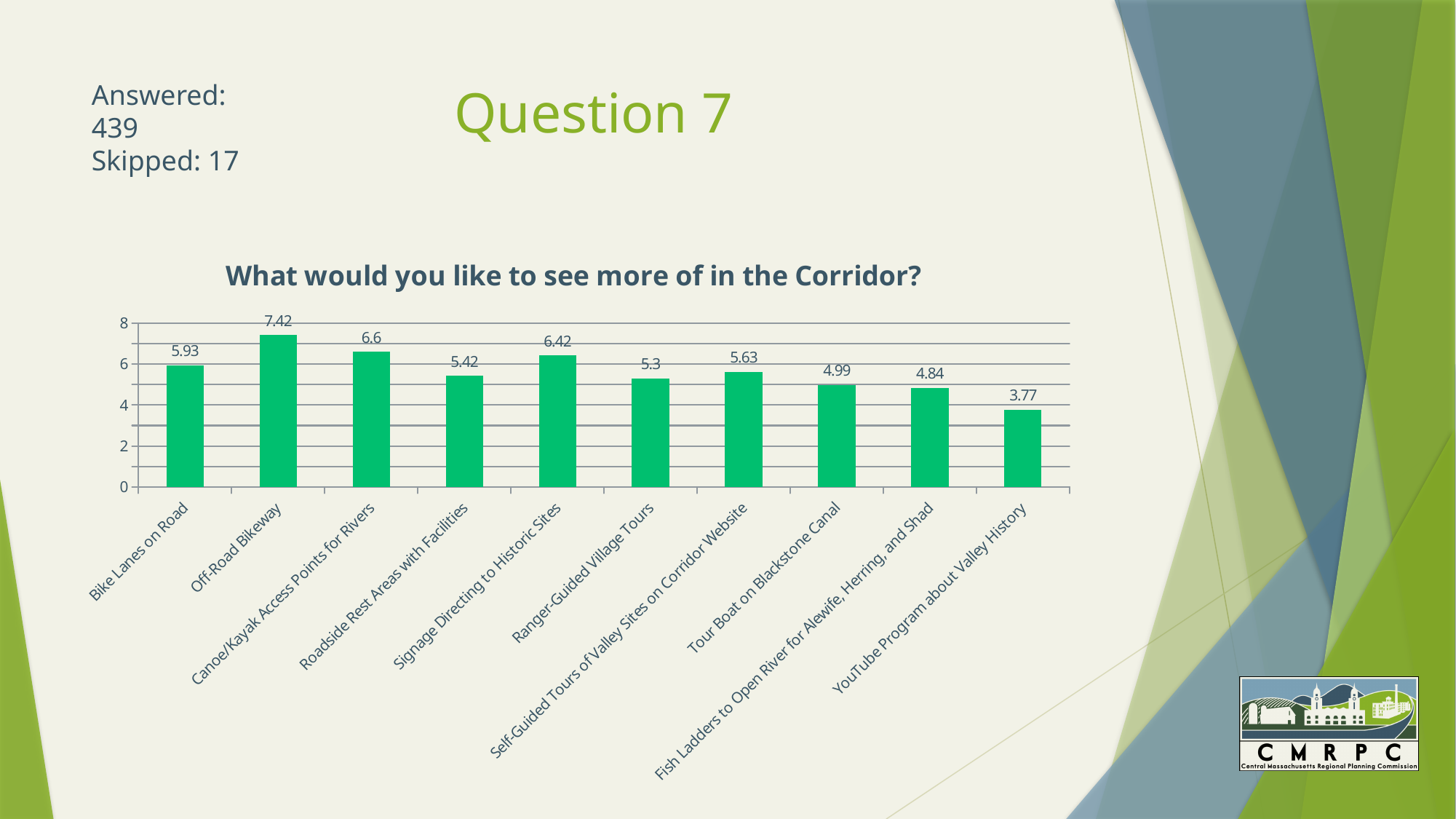
Which is larger, the value for Bike Lanes on Road or the value for Roadside Rest Areas with Facilities? Bike Lanes on Road What is the difference between the values for Off-Road Bikeway and YouTube Program about Valley History? 3.65 What is the value for Off-Road Bikeway? 7.42 What is the title of the chart? What would you like to see more of in the Corridor? What is the difference between the values for Self-Guided Tours of Valley Sites on Corridor Website and Ranger-Guided Village Tours? 0.33 What kind of chart is shown on the slide? Bar chart What is the value for Tour Boat on Blackstone Canal? 4.99 How many categories are shown in the chart? 10 Which category has the highest value? Off-Road Bikeway What is the value for Signage Directing to Historic Sites? 6.42 Which category has the lowest value? YouTube Program about Valley History Is the value for Canoe/Kayak Access Points for Rivers greater or less than 6? greater